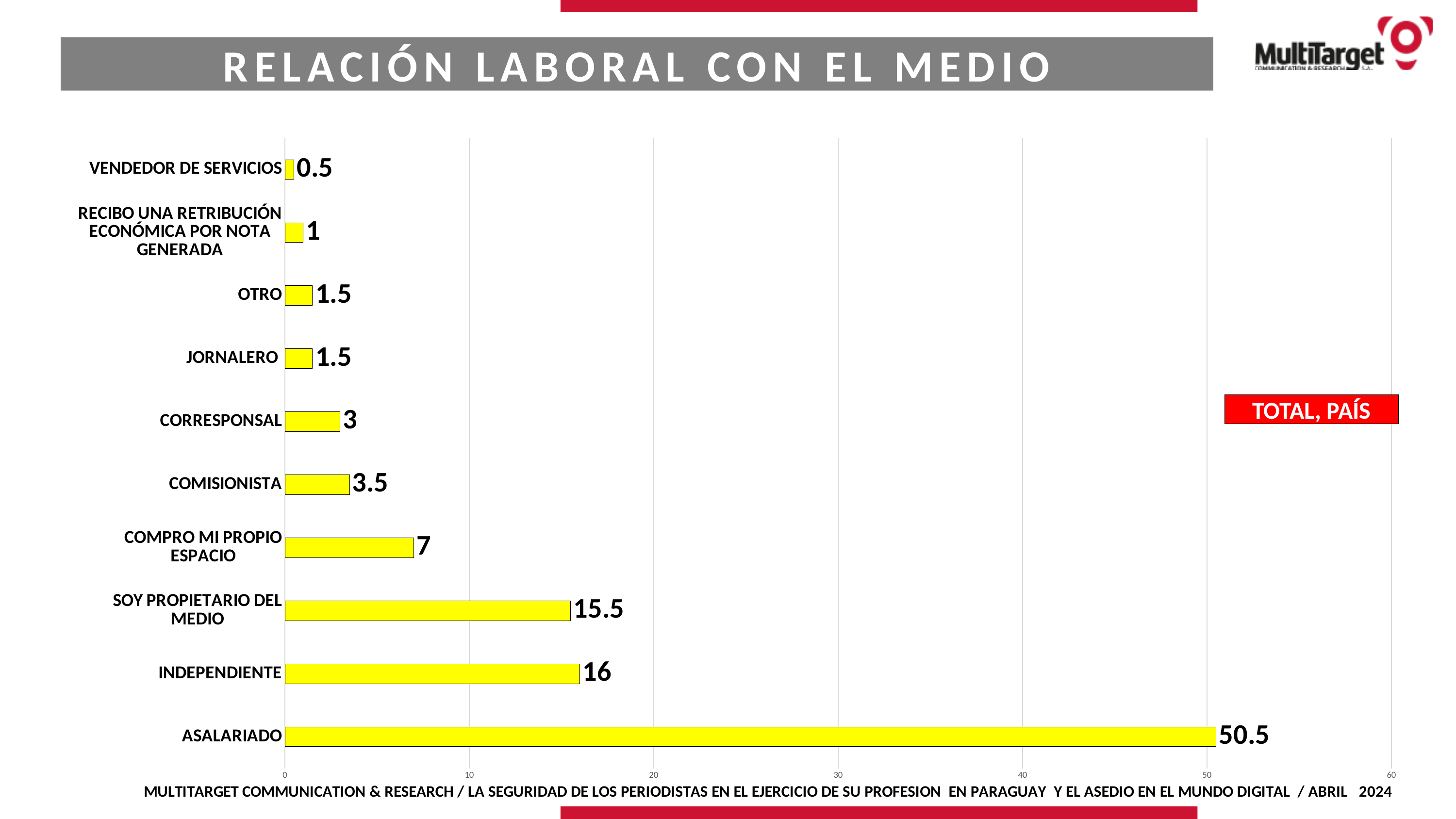
What is the value for COMPRO MI PROPIO ESPACIO? 7 What is the value for SOY PROPIETARIO DEL MEDIO? 15.5 What kind of chart is shown on the slide? Bar chart What is the difference between the values for COMPRO MI PROPIO ESPACIO and COMISIONISTA? 3.5 What is the title of the slide? RELACIÓN LABORAL CON EL MEDIO What is the difference between the values for ASALARIADO and INDEPENDIENTE? 34.5 Which category has the lowest value? VENDEDOR DE SERVICIOS What is the value for ASALARIADO? 50.5 What is the value for INDEPENDIENTE? 16 Which category has the highest value? ASALARIADO Which is larger, the value for CORRESPONSAL or the value for COMISIONISTA? COMISIONISTA How many categories are shown in the chart? 10